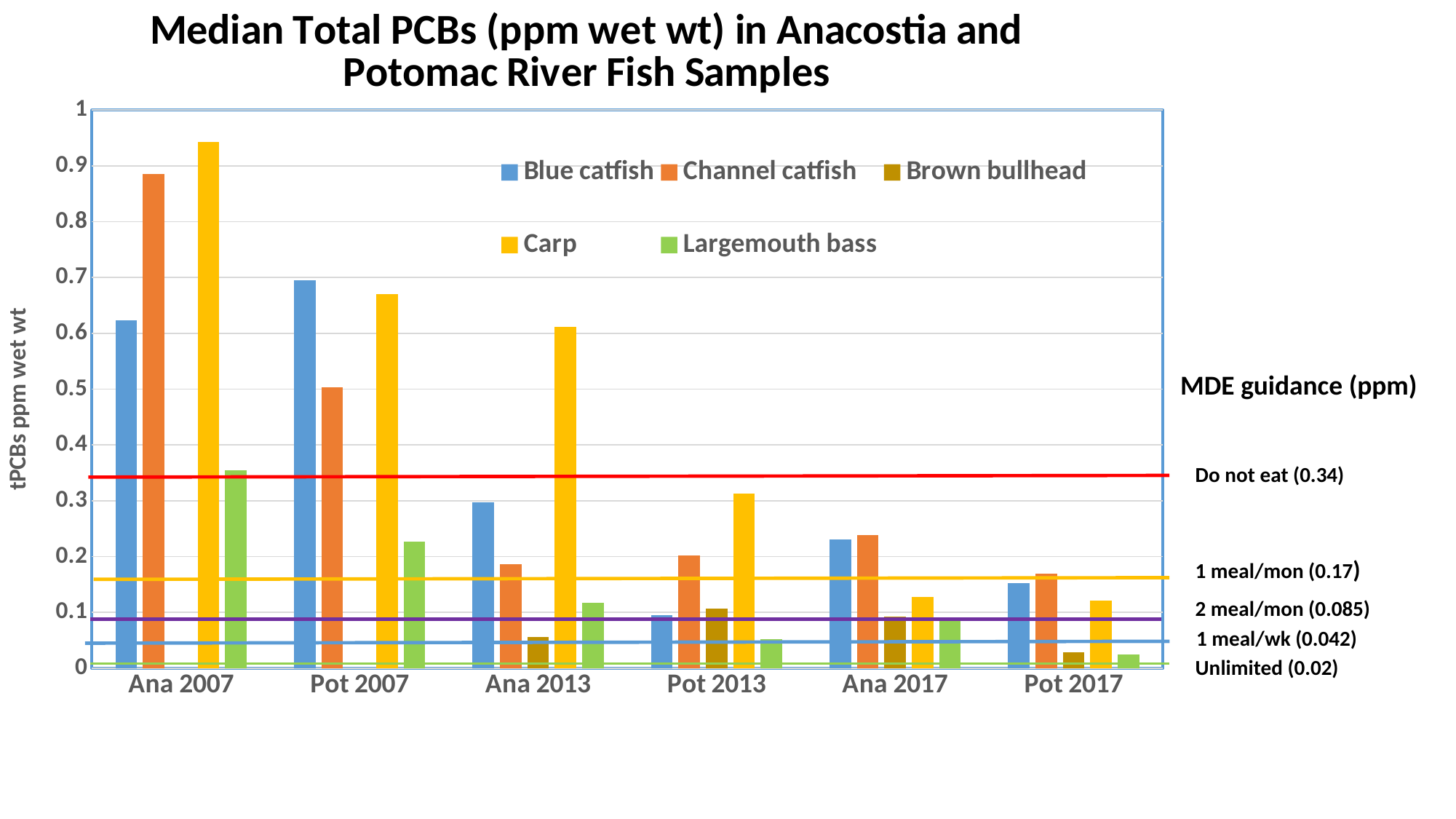
How many series does the legend list? 5 What PCB level does the red 'Do not eat' MDE guidance line mark? 0.34 Which fish species has the highest median total PCB value in Ana 2013? Carp Which fish species has the highest median total PCB value in Ana 2007? Carp What kind of chart is shown on the slide? bar chart How many categories are shown along the x axis? 6 Do the Carp values for the Anacostia River rise or fall from 2007 to 2017? fall Is the value for Carp in Ana 2007 greater or less than 0.9? greater Which is larger, the Carp value for Ana 2007 or the Carp value for Pot 2007? Ana 2007 Is the value for Largemouth bass in Ana 2007 greater or less than 0.3? greater Which fish species has the lowest median total PCB value in Ana 2013? Brown bullhead